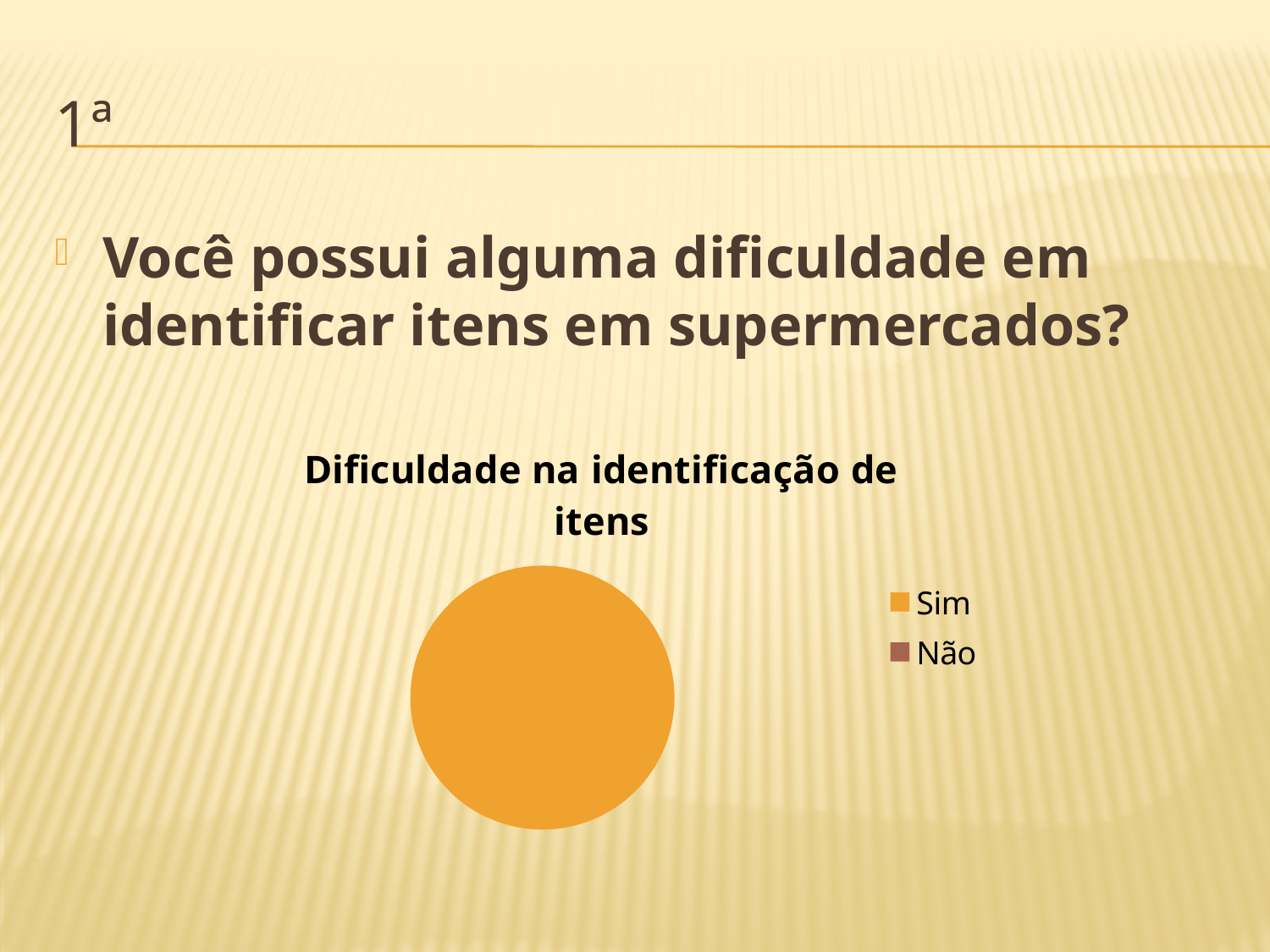
Which colour represents Sim in the legend? orange How many entries does the chart's legend list? 2 What is the title of the chart? Dificuldade na identificação de itens How many categories are listed in the chart's legend? 2 Which category has the largest slice of the pie? Sim What kind of chart is shown on the slide? pie chart Which slice is larger, Sim or Não? Sim Which category has the smallest slice of the pie? Não